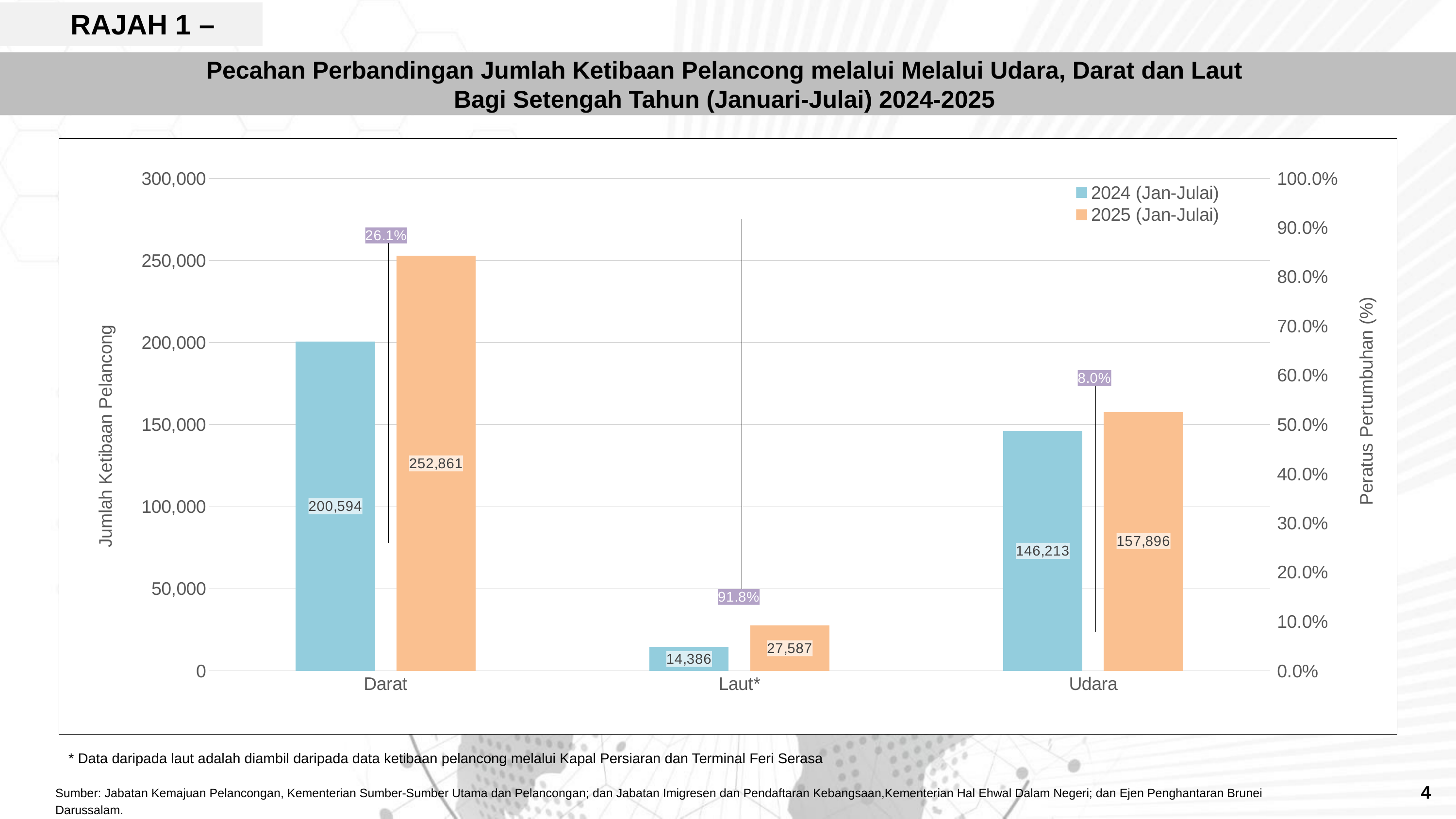
What growth percentage is shown above the Laut* bars? 91.8% What kind of chart is shown on the slide? Bar chart Which category has the lowest value in the 2024 (Jan-Julai) series? Laut* What is the value for Laut* in the 2025 (Jan-Julai) series? 27,587 What is the value for Udara in the 2024 (Jan-Julai) series? 146,213 What is the difference between the 2025 (Jan-Julai) and 2024 (Jan-Julai) values for Udara? 11,683 What is the value for Darat in the 2024 (Jan-Julai) series? 200,594 How many categories are shown on the x axis? 3 How many series does the legend list? 2 What is the difference between the 2025 (Jan-Julai) and 2024 (Jan-Julai) values for Darat? 52,267 Which is larger: the 2024 (Jan-Julai) value for Udara or the 2025 (Jan-Julai) value for Laut*? 2024 (Jan-Julai) value for Udara Which category has the highest value in the 2025 (Jan-Julai) series? Darat